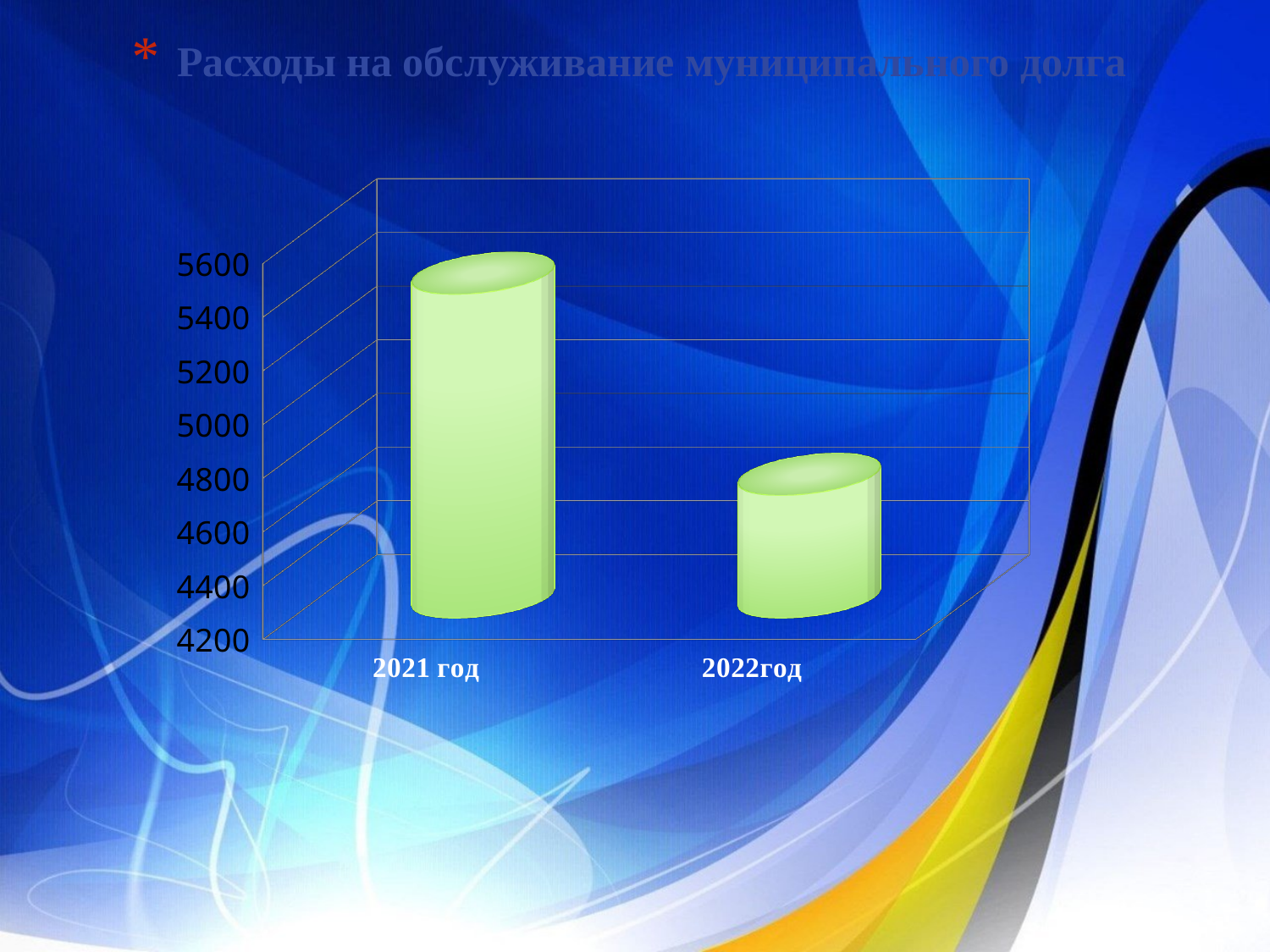
What is the lowest value shown on the y axis of the chart? 4200 Is the value for 2022год greater or less than 5000? less How many categories are shown on the x axis of the chart? 2 What is the title of the slide containing the chart? Расходы на обслуживание муниципального долга Is the value for 2021 год greater or less than 5000? greater Do the values rise or fall from 2021 год to 2022год? fall What colour are the bars in the chart? green Is the value for 2022год greater or less than 4400? greater Which year has the lowest value in the chart? 2022год What kind of chart is shown on the slide? bar chart Which is larger, the value for 2021 год or the value for 2022год? 2021 год Which year has the highest value in the chart? 2021 год